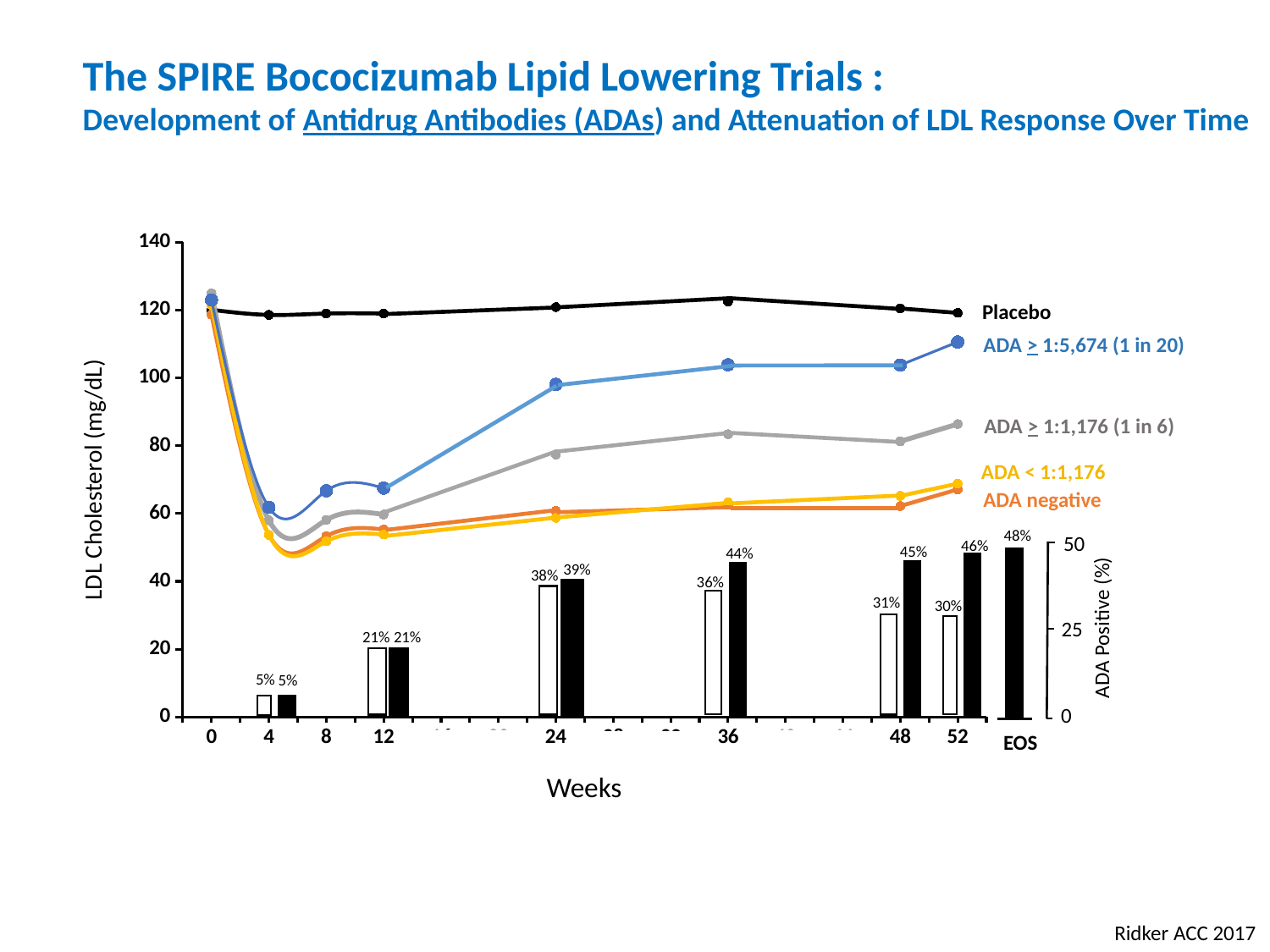
What is the ADA positive percentage shown at EOS? 48% At week 36, which bar is larger, the white bar or the black bar? The black bar (44%) What is the value of the black bar at week 36? 44% Is the Placebo LDL cholesterol value at week 52 greater or less than 100? greater What is the difference between the black bar and the white bar at week 52? 16 percentage points At which time point is the black bar highest? EOS (48%) Is the LDL cholesterol value for ADA > 1:5,674 at week 4 greater or less than 80? less How many LDL cholesterol line series are labelled on the chart? 5 What is the value of the white bar at week 48? 31% What kind of chart is shown on the slide? A combined line and bar chart Do the black ADA positive bars rise or fall from week 4 to EOS? rise At which week are the ADA positive bars lowest? Week 4 (5%)